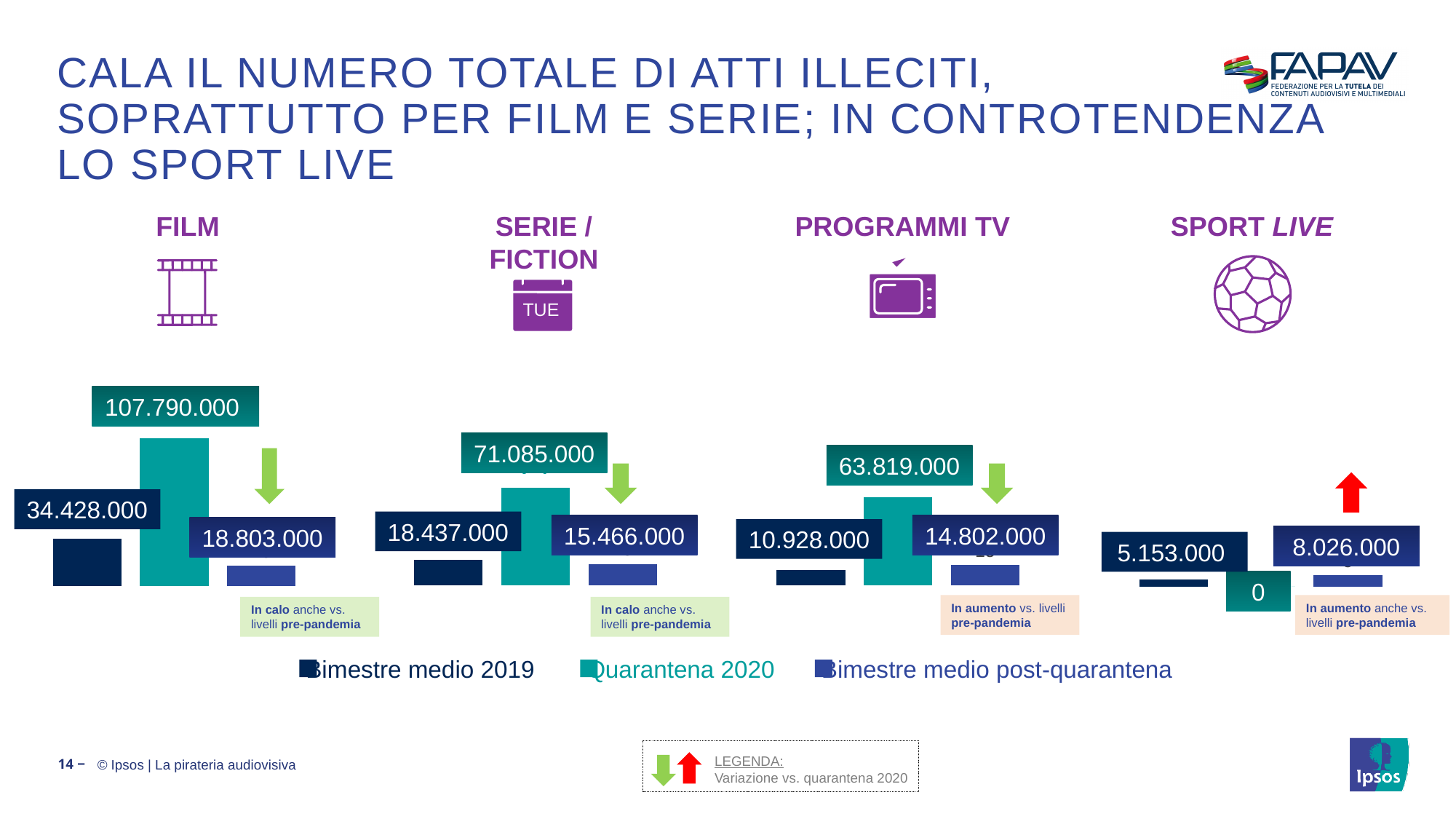
What is the value for Serie / Fiction during Quarantena 2020? 71.085.000 Which category has the lowest value in the Bimestre medio 2019? Sport Live What is the difference between the Quarantena 2020 and Bimestre medio 2019 values for Film? 73.362.000 What is the value for Sport Live during Quarantena 2020? 0 Which category has the highest value during Quarantena 2020? Film What is the value for Programmi TV in the Bimestre medio post-quarantena? 14.802.000 How many series does the legend list? 3 What is the value for Sport Live in the Bimestre medio 2019? 5.153.000 What is the difference between the Bimestre medio post-quarantena and Bimestre medio 2019 values for Sport Live? 2.873.000 For Programmi TV, which is larger: the Bimestre medio 2019 value or the Bimestre medio post-quarantena value? Bimestre medio post-quarantena What kind of chart is shown on the slide? Bar chart What is the value for Film during Quarantena 2020? 107.790.000